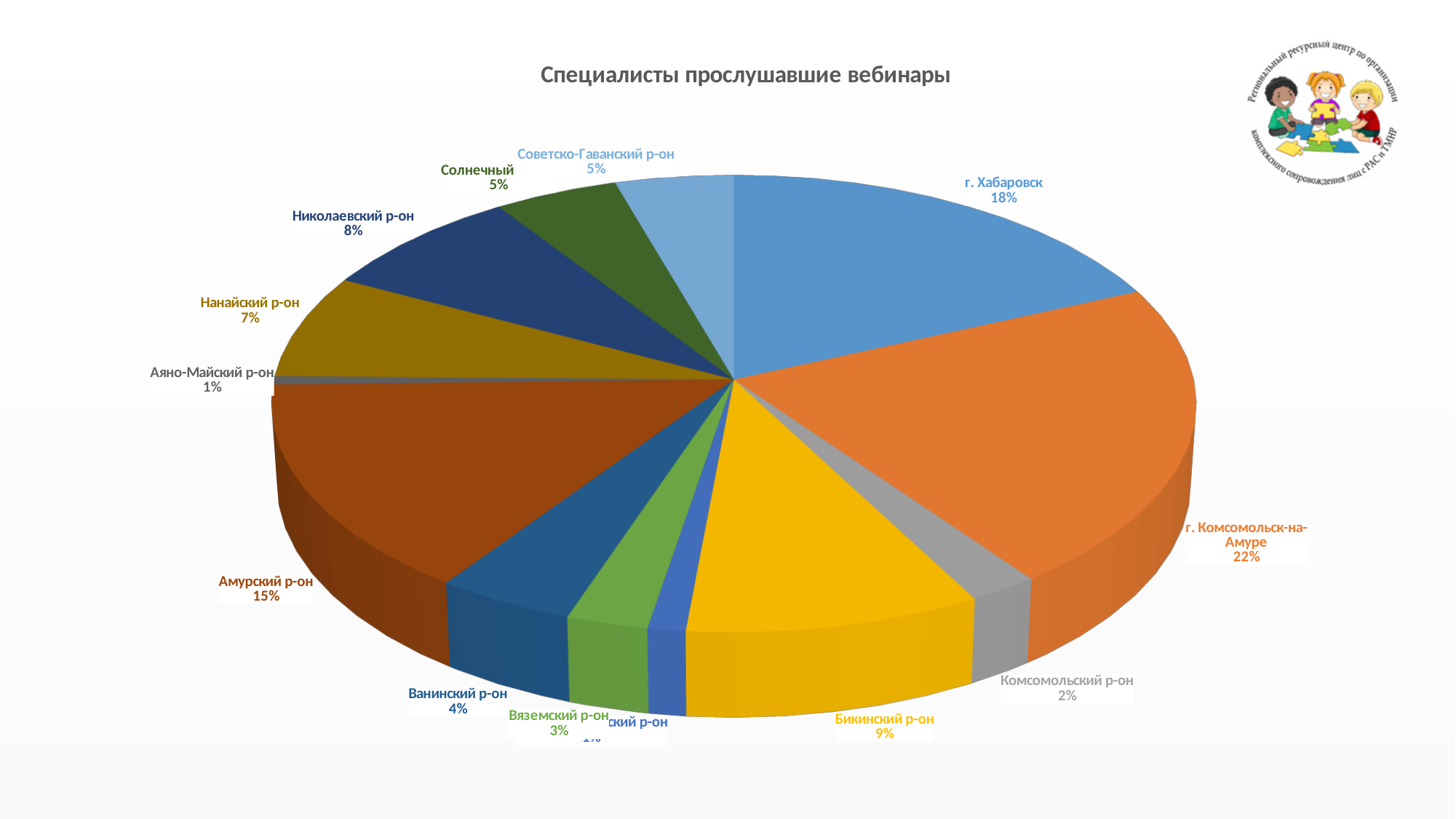
Which is larger, the share for Нанайский р-он or the share for Ванинский р-он? Нанайский р-он What share of the pie does Комсомольский р-он have? 2% What share of the pie does Бикинский р-он have? 9% What share of the pie does г. Хабаровск have? 18% What kind of chart is shown on the slide? pie chart What share of the pie does Николаевский р-он have? 8% What share of the pie does Амурский р-он have? 15% Which category has the largest share of the pie? г. Комсомольск-на-Амуре What share of the pie does Советско-Гаванский р-он have? 5% What is the difference in percentage points between г. Комсомольск-на-Амуре and г. Хабаровск? 4 What is the title of the chart? Специалисты прослушавшие вебинары What is the difference in percentage points between Амурский р-он and Бикинский р-он? 6